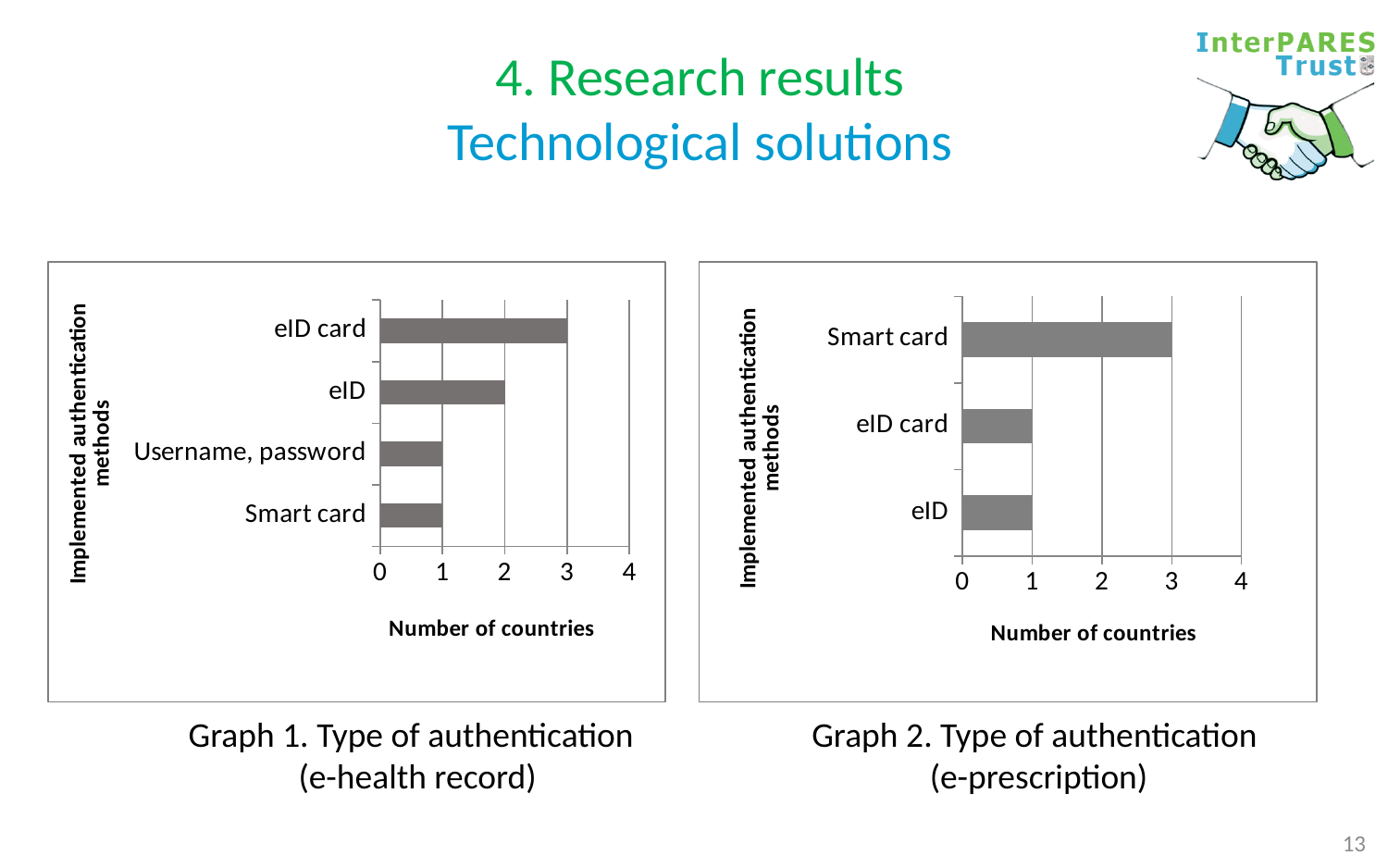
In Graph 1 (e-health record), how many authentication methods are shown? 4 In Graph 1 (e-health record), which authentication method has the highest number of countries? eID card In Graph 2 (e-prescription), what is the difference in number of countries between Smart card and eID? 2 In Graph 2 (e-prescription), which authentication method has the highest number of countries? Smart card In Graph 2 (e-prescription), how many countries implemented Smart card authentication? 3 In Graph 1 (e-health record), how many countries implemented eID authentication? 2 What type of chart is Graph 2 (e-prescription)? Bar chart In Graph 1 (e-health record), which has more countries: eID or Smart card? eID In Graph 1 (e-health record), how many countries implemented eID card authentication? 3 In Graph 2 (e-prescription), how many authentication methods are shown? 3 In Graph 2 (e-prescription), how many countries implemented eID card authentication? 1 In Graph 1 (e-health record), what is the difference in number of countries between eID card and Username, password? 2